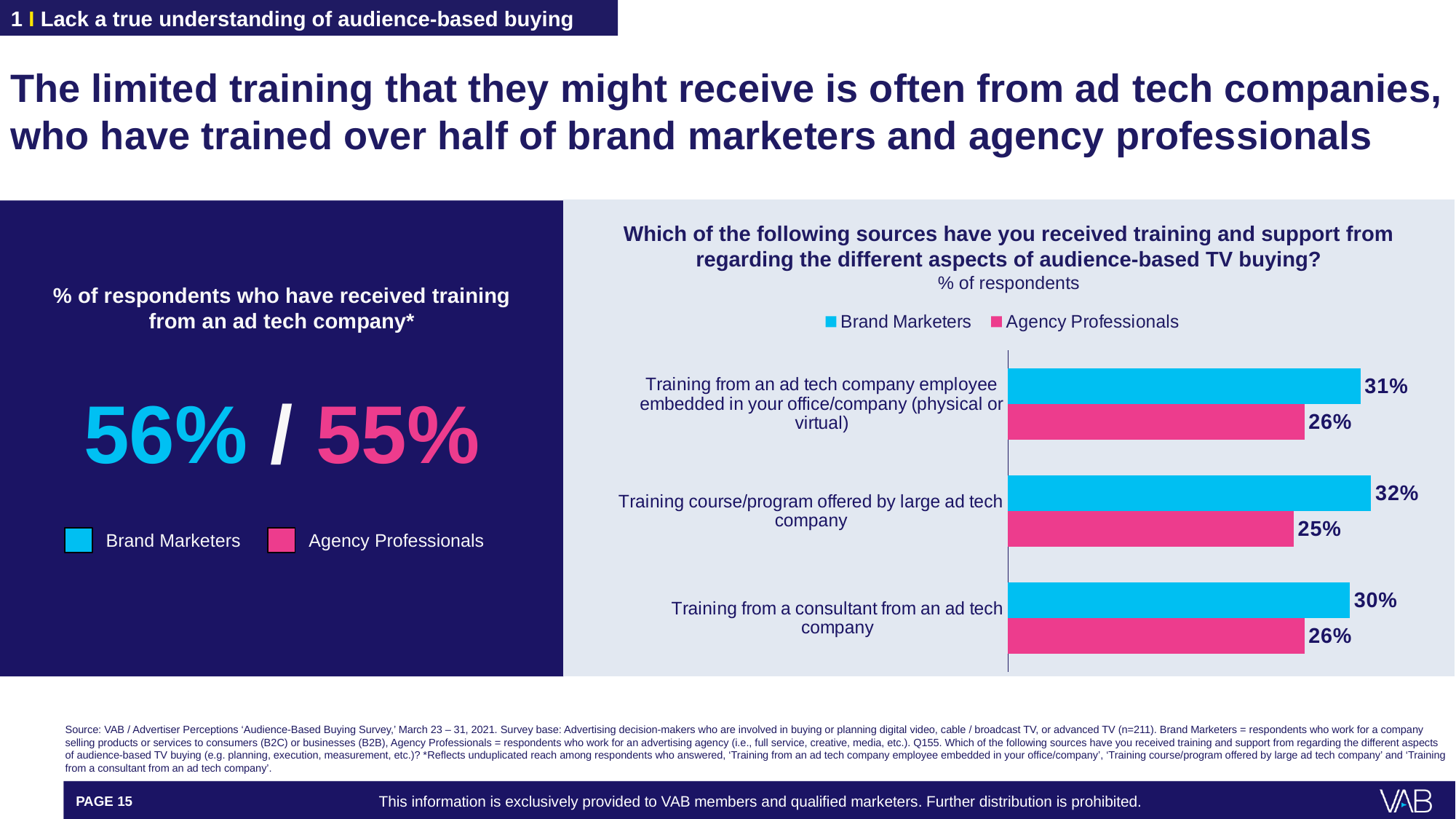
What percentage of Agency Professionals received training from a training course/program offered by a large ad tech company? 25% Which colour represents Agency Professionals in the bar chart? Pink What percentage of Brand Marketers received training from a consultant from an ad tech company? 30% What is the difference between Brand Marketers and Agency Professionals for the training course/program offered by a large ad tech company? 7% How many series does the bar chart's legend list? 2 What percentage of Agency Professionals received training from a consultant from an ad tech company? 26% What percentage of Brand Marketers received training from an ad tech company employee embedded in their office/company? 31% Which training source has the highest value for Brand Marketers? Training course/program offered by large ad tech company How many training sources (categories) are shown in the bar chart? 3 What type of chart is used to show the training sources? Bar chart For training from an ad tech company employee embedded in the office/company, which group has the larger value, Brand Marketers or Agency Professionals? Brand Marketers Which training source has the lowest value for Agency Professionals? Training course/program offered by large ad tech company